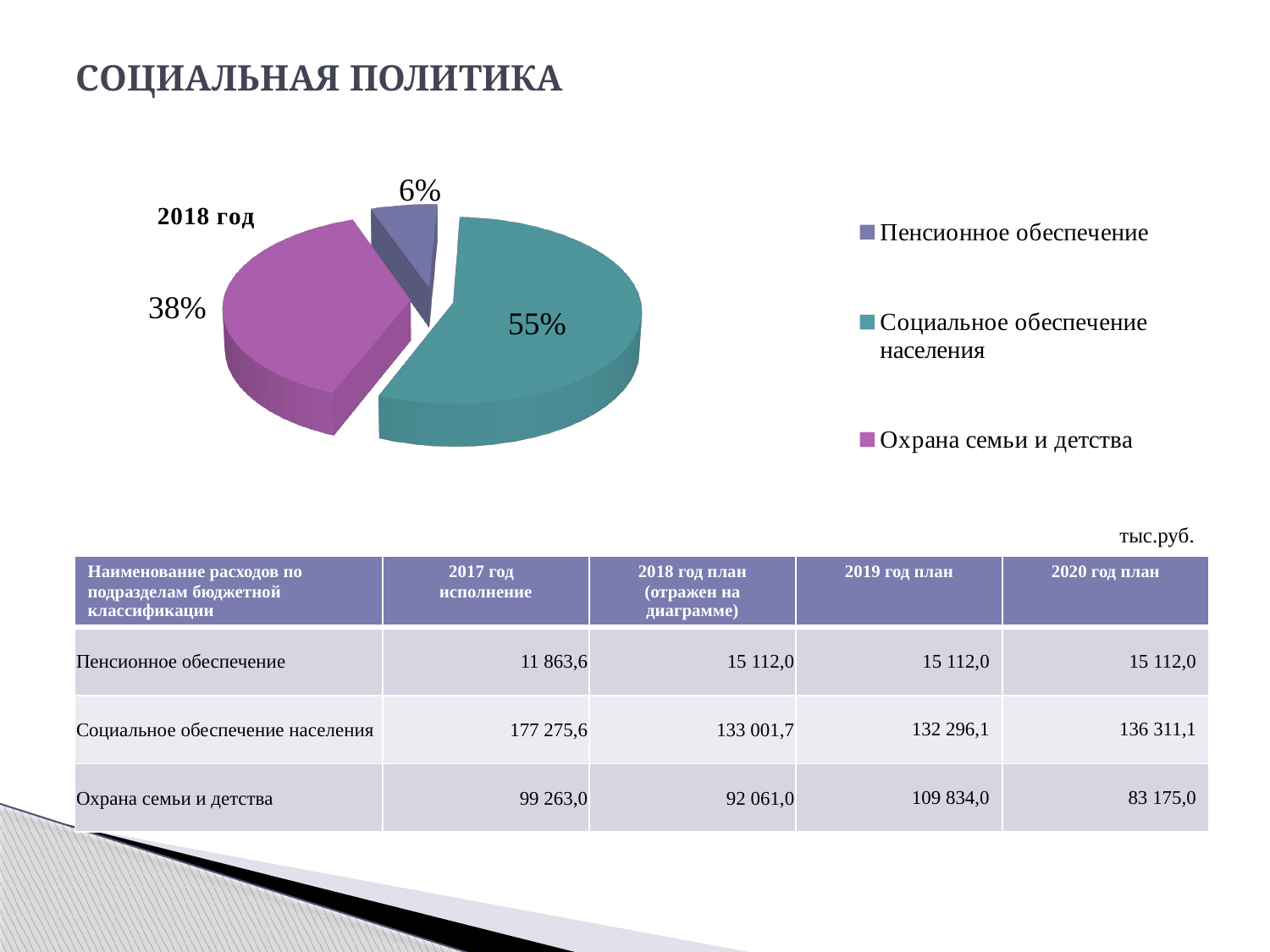
What is the difference in percentage points between the Социальное обеспечение населения slice and the Охрана семьи и детства slice? 17 Which slice is larger: Охрана семьи и детства or Пенсионное обеспечение? Охрана семьи и детства What share of the pie does Охрана семьи и детства have? 38% What share of the pie does Пенсионное обеспечение have? 6% How many slices does the pie chart have? 3 How many entries does the legend list? 3 What kind of chart is shown on the slide? Pie chart Which legend entry is shown in teal? Социальное обеспечение населения Which category has the smallest slice of the pie? Пенсионное обеспечение Which category has the largest slice of the pie? Социальное обеспечение населения What share of the pie does Социальное обеспечение населения have? 55% Which year is the pie chart labelled with? 2018 год